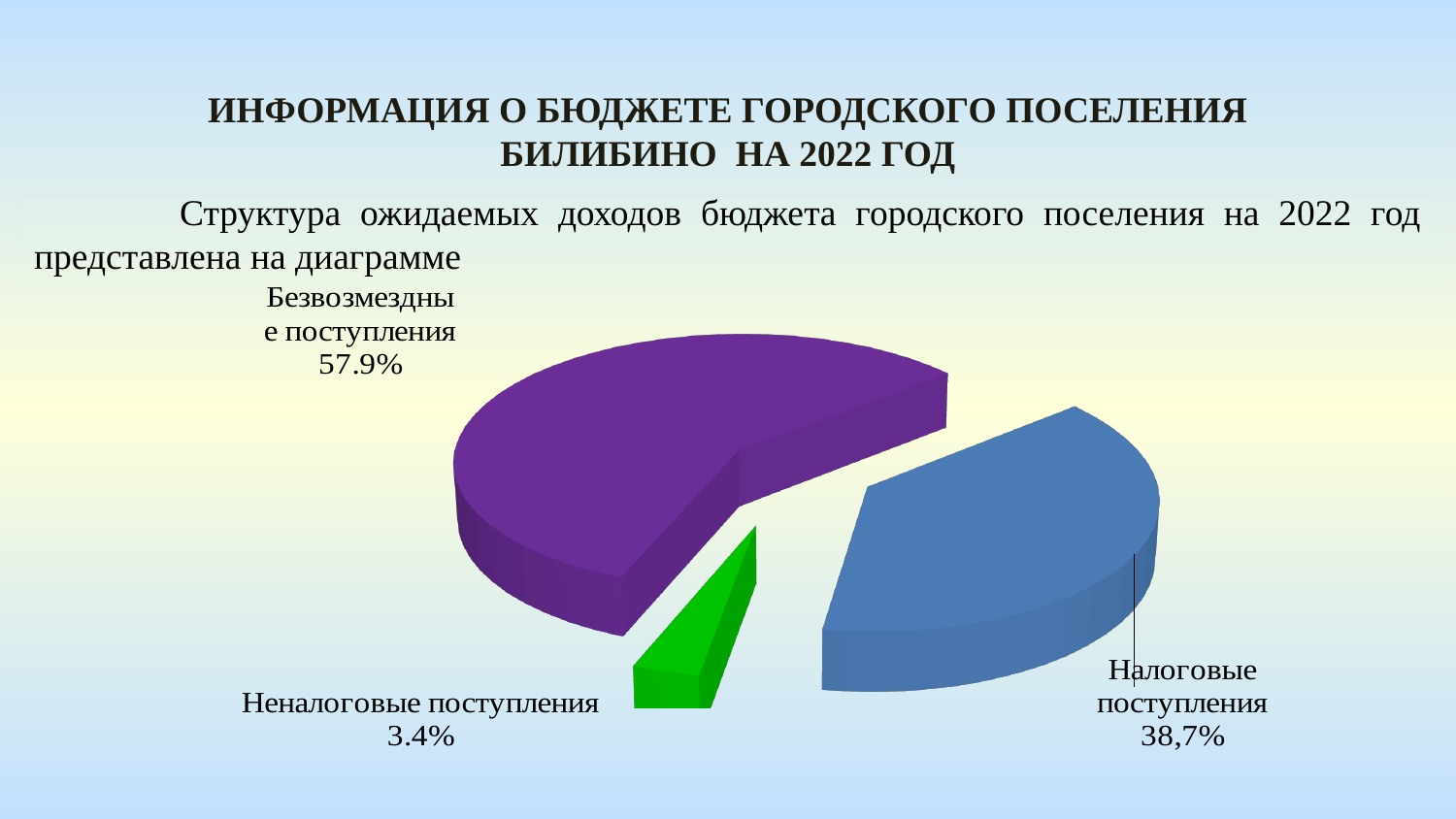
How many slices does the pie chart have? 3 What share of the pie is labelled for Безвозмездные поступления? 57.9% By how many percentage points does the share of Безвозмездные поступления exceed the share of Налоговые поступления? 19.2 percentage points What share of the pie is labelled for Налоговые поступления? 38,7% Which category has the smallest slice of the pie? Неналоговые поступления What kind of chart is shown on the slide? Pie chart Which is larger: the slice for Безвозмездные поступления or the slice for Налоговые поступления? Безвозмездные поступления What colour is the slice for Неналоговые поступления? Green Which category has the largest slice of the pie? Безвозмездные поступления What colour is the slice for Безвозмездные поступления? Purple What share of the pie is labelled for Неналоговые поступления? 3.4% Which is larger: the slice for Налоговые поступления or the slice for Неналоговые поступления? Налоговые поступления